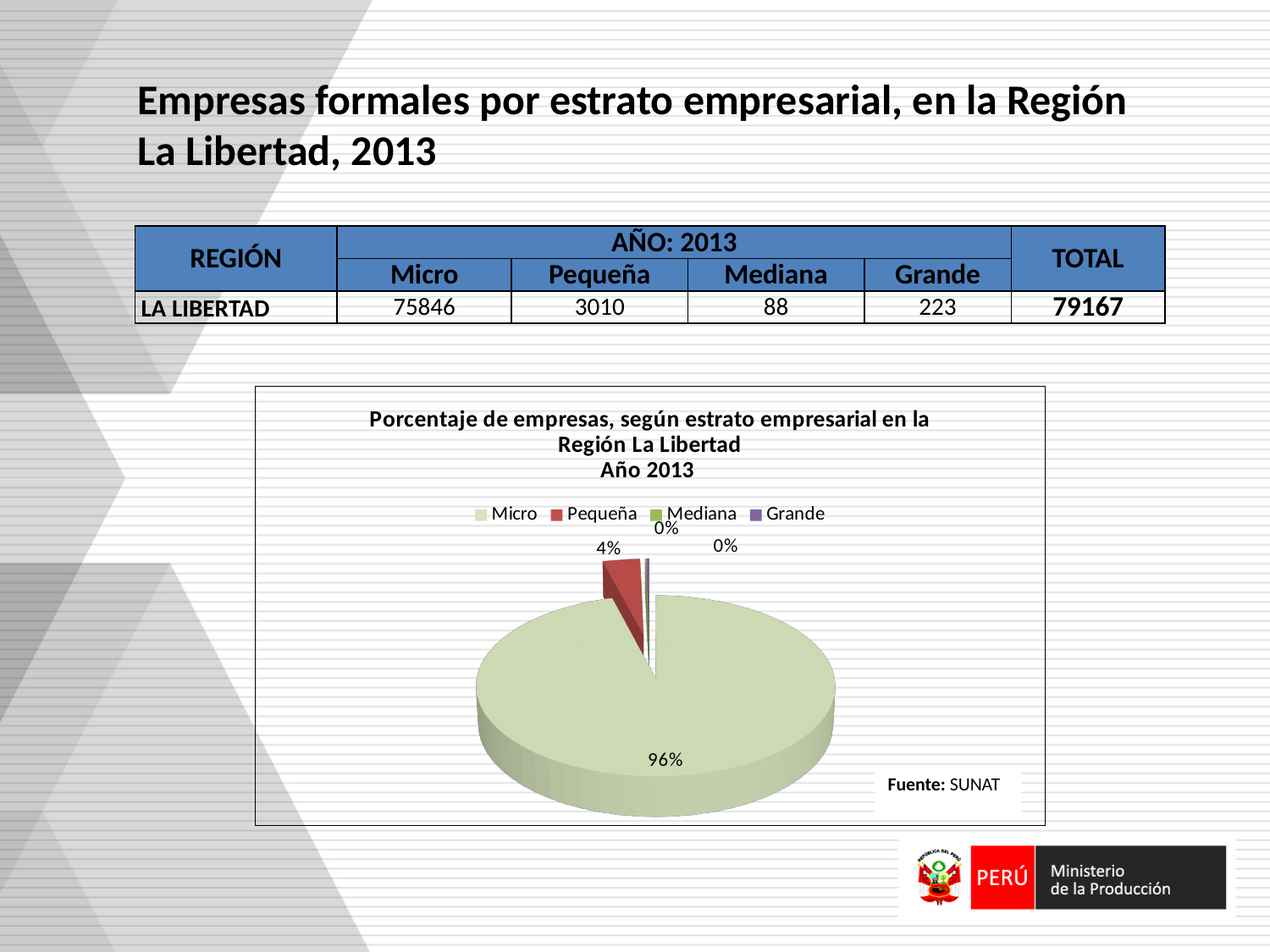
What source is cited for the pie chart? SUNAT How many categories does the pie chart legend list? 4 What percentage of the pie chart does the Micro slice represent? 96% What type of chart is shown on the slide? Pie chart What is the difference in percentage points between the Micro slice and the Pequeña slice? 92 percentage points How many slices are labelled in the pie chart? 4 Which slice is larger in the pie chart, Micro or Pequeña? Micro What percentage of the pie chart does the Pequeña slice represent? 4% What is the title of the pie chart? Porcentaje de empresas, según estrato empresarial en la Región La Libertad Año 2013 What percentage is shown for the Grande slice in the pie chart? 0% Which category has the largest slice in the pie chart? Micro What percentage is shown for the Mediana slice in the pie chart? 0%